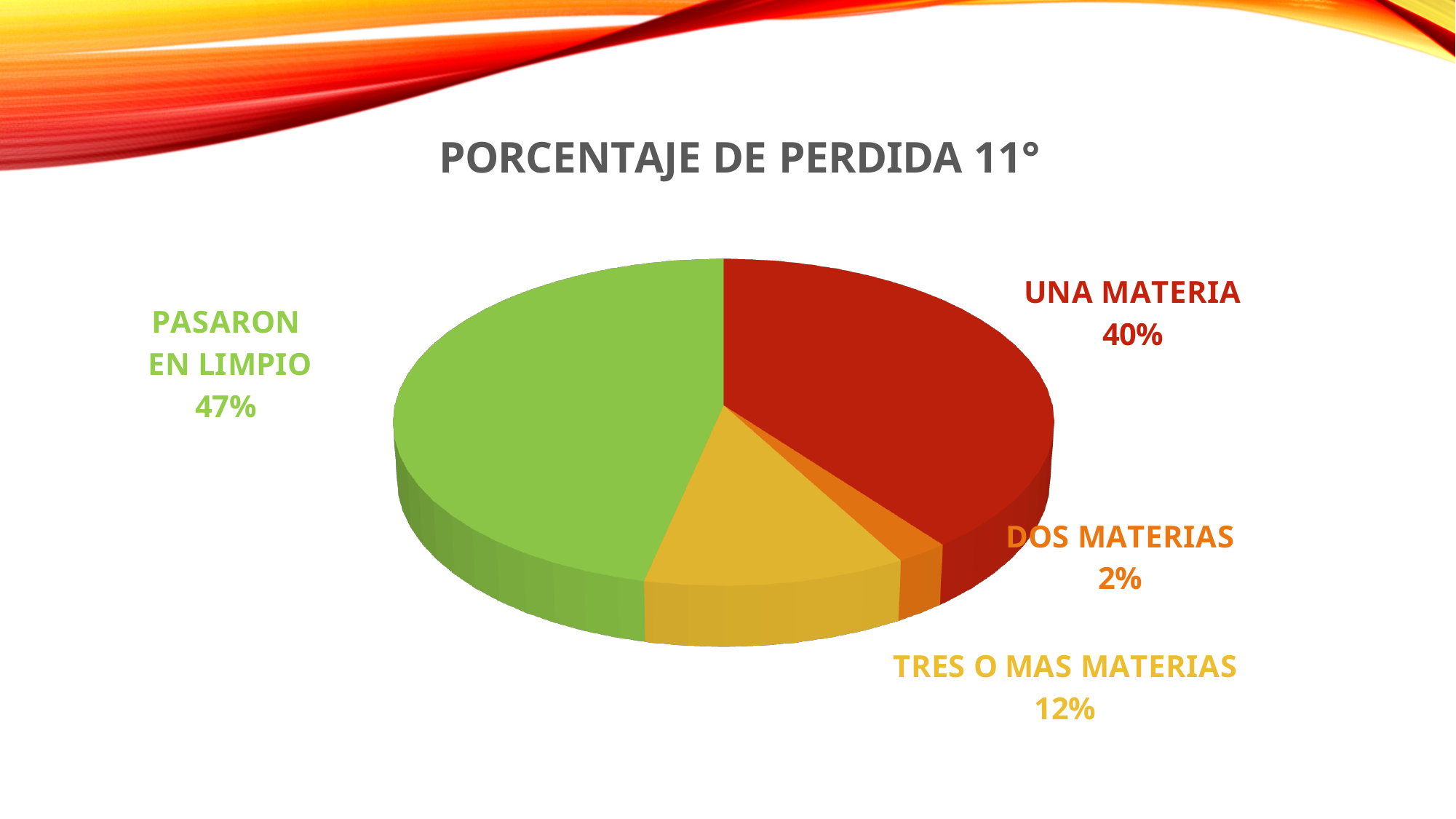
Which is larger, the share for UNA MATERIA or the share for TRES O MAS MATERIAS? UNA MATERIA What percentage is shown for UNA MATERIA? 40% How many slices does the pie chart have? 4 What is the difference in percentage points between PASARON EN LIMPIO and UNA MATERIA? 7 Which category has the largest share of the pie? PASARON EN LIMPIO What percentage is shown for TRES O MAS MATERIAS? 12% What kind of chart is shown on the slide? Pie chart What percentage of the pie is labelled PASARON EN LIMPIO? 47% Which category has the smallest share of the pie? DOS MATERIAS What is the title of the chart? PORCENTAJE DE PERDIDA 11° What percentage is shown for DOS MATERIAS? 2% What is the difference in percentage points between TRES O MAS MATERIAS and DOS MATERIAS? 10